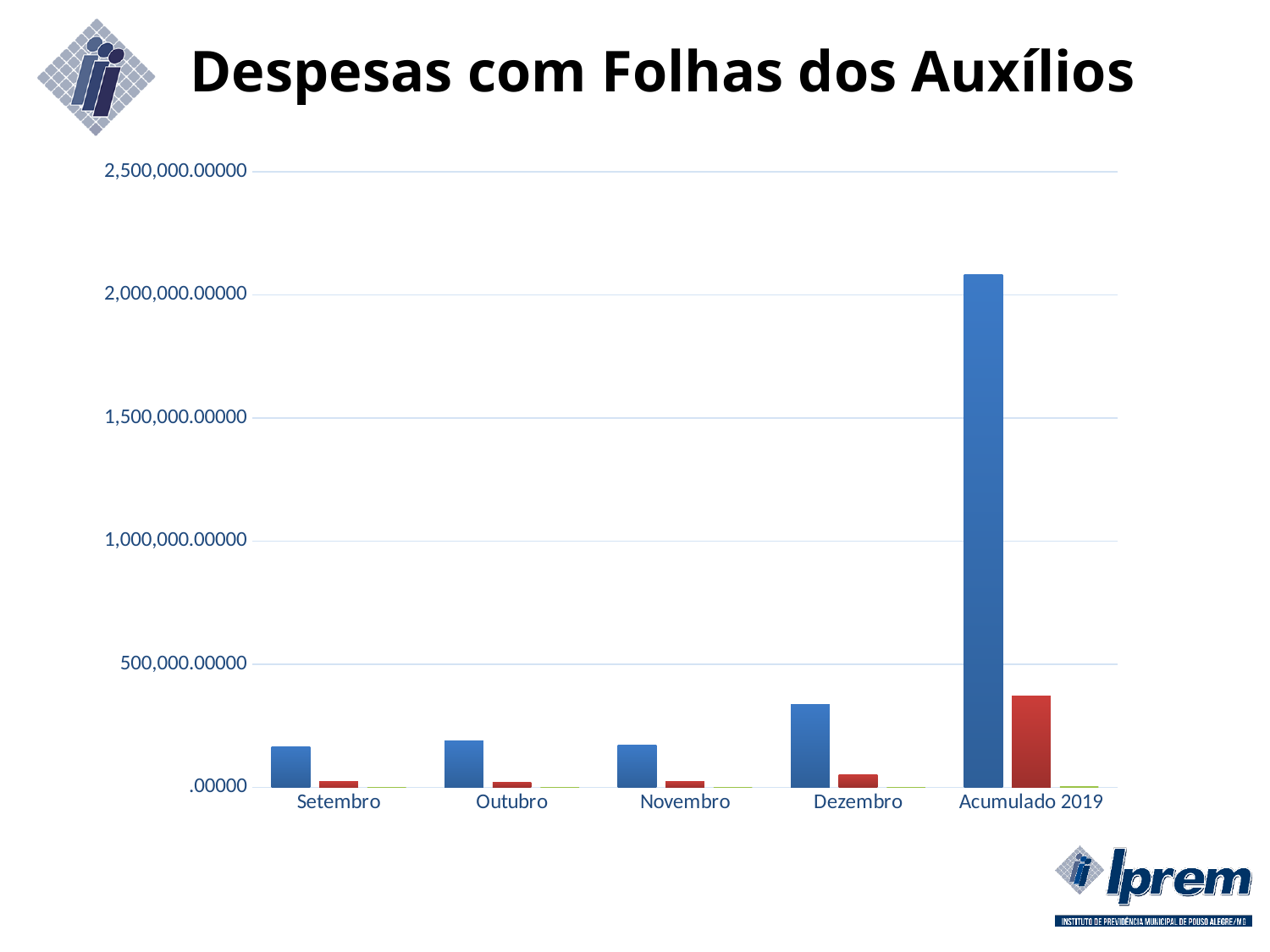
Which is larger, the blue bar for Dezembro or the blue bar for Outubro? Dezembro In Acumulado 2019, which is larger, the blue bar or the red bar? the blue bar Which category has the tallest blue bar? Acumulado 2019 Is the blue bar for Dezembro greater or less than 500,000.00000? less How many categories are shown on the x axis? 5 What kind of chart is shown on the slide? bar chart What is the highest value shown on the y axis? 2,500,000.00000 How many bars are plotted for each category? 3 Among the four months (Setembro, Outubro, Novembro, Dezembro), which has the tallest blue bar? Dezembro Is the blue bar for Acumulado 2019 greater or less than 2,000,000.00000? greater Is the red bar for Acumulado 2019 greater or less than 500,000.00000? less What is the title of the slide's chart? Despesas com Folhas dos Auxílios